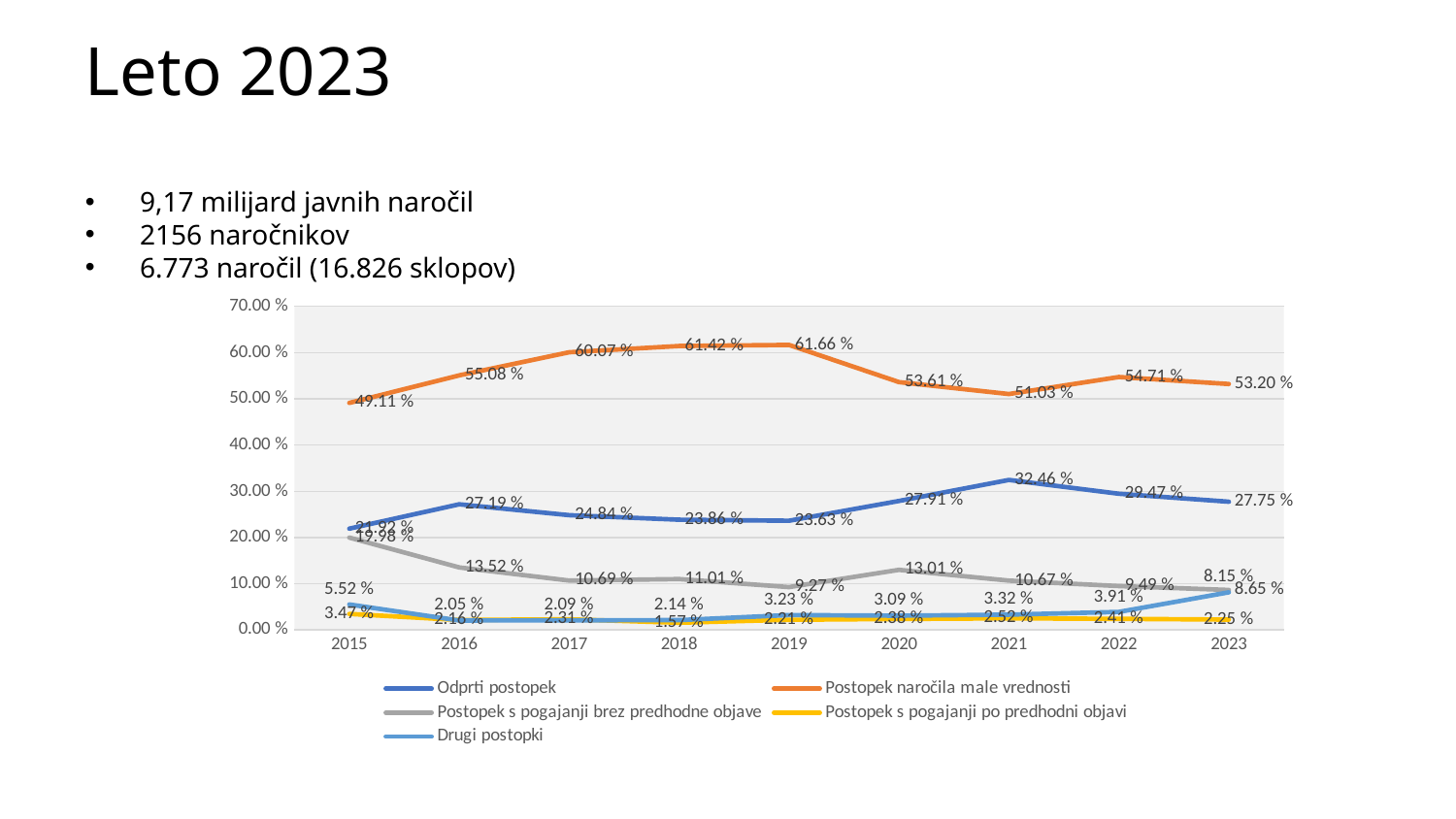
How many series does the legend list? 5 What is the value for Postopek naročila male vrednosti in 2019? 61.66 % What is the value for Drugi postopki in 2023? 8.15 % In 2023, which is larger: Odprti postopek or Postopek s pogajanji brez predhodne objave? Odprti postopek What is the difference between the Postopek naročila male vrednosti values in 2019 and 2015? 12.55 % Does the value for Postopek s pogajanji brez predhodne objave rise or fall from 2015 to 2017? fall What is the value for Postopek s pogajanji brez predhodne objave in 2015? 19.98 % What kind of chart is shown on the slide? line chart In which year is Postopek naročila male vrednosti at its lowest? 2015 How many years are plotted along the x axis? 9 In which year is Odprti postopek at its highest? 2021 What is the value for Odprti postopek in 2021? 32.46 %